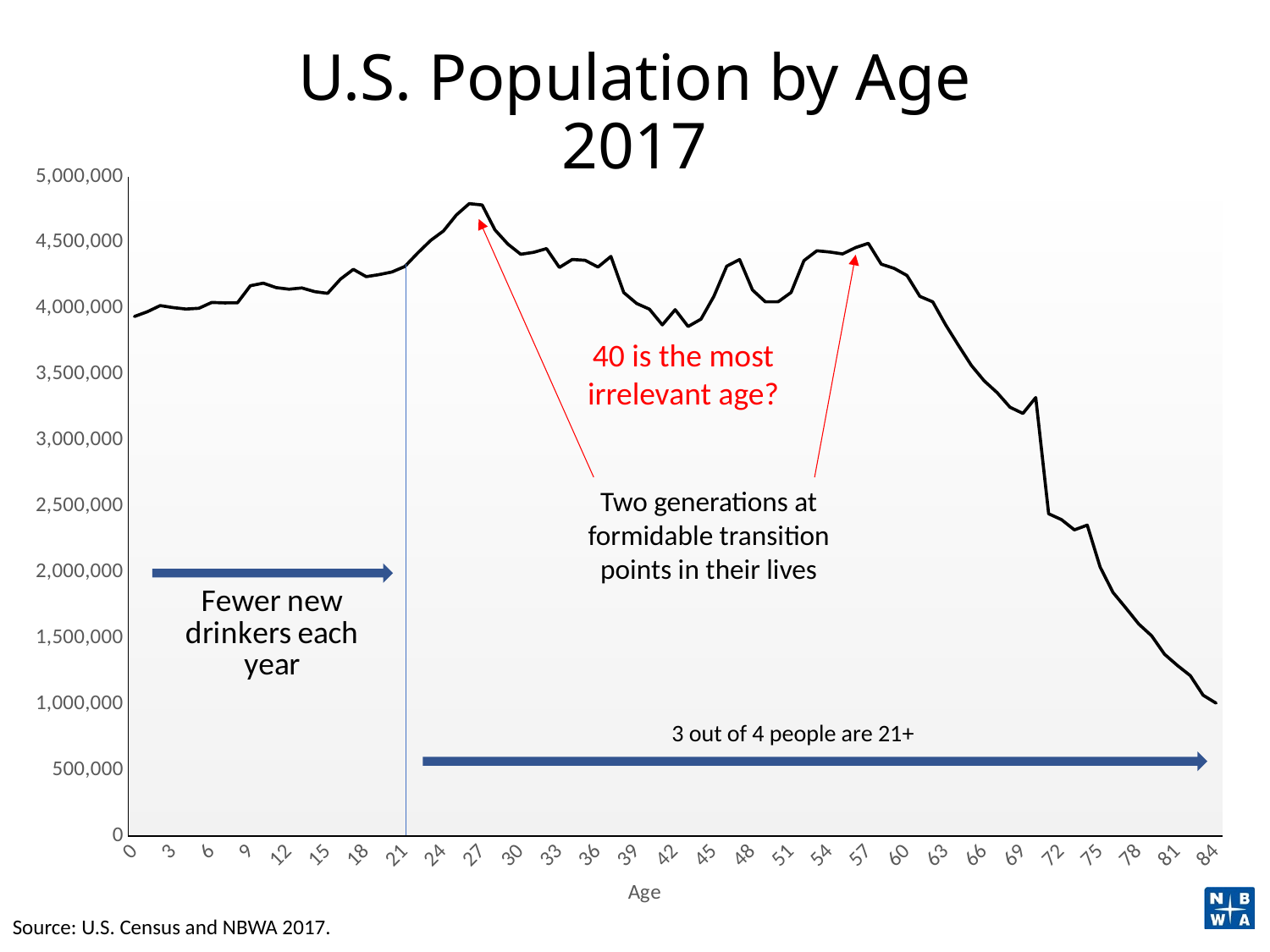
Is the value for age 27 greater or less than 4,500,000? greater What kind of chart is shown on the slide? line chart Is the value for age 84 greater or less than 1,500,000? less Is the value for age 57 greater or less than 4,000,000? greater Which age has the larger population, 21 or 72? 21 What is the label of the x axis? Age At which age does the population line reach its lowest point? 84 Do the values rise or fall along the x axis from age 60 to age 84? fall Which age has the larger population, 27 or 57? 27 What is the title of the chart? U.S. Population by Age 2017